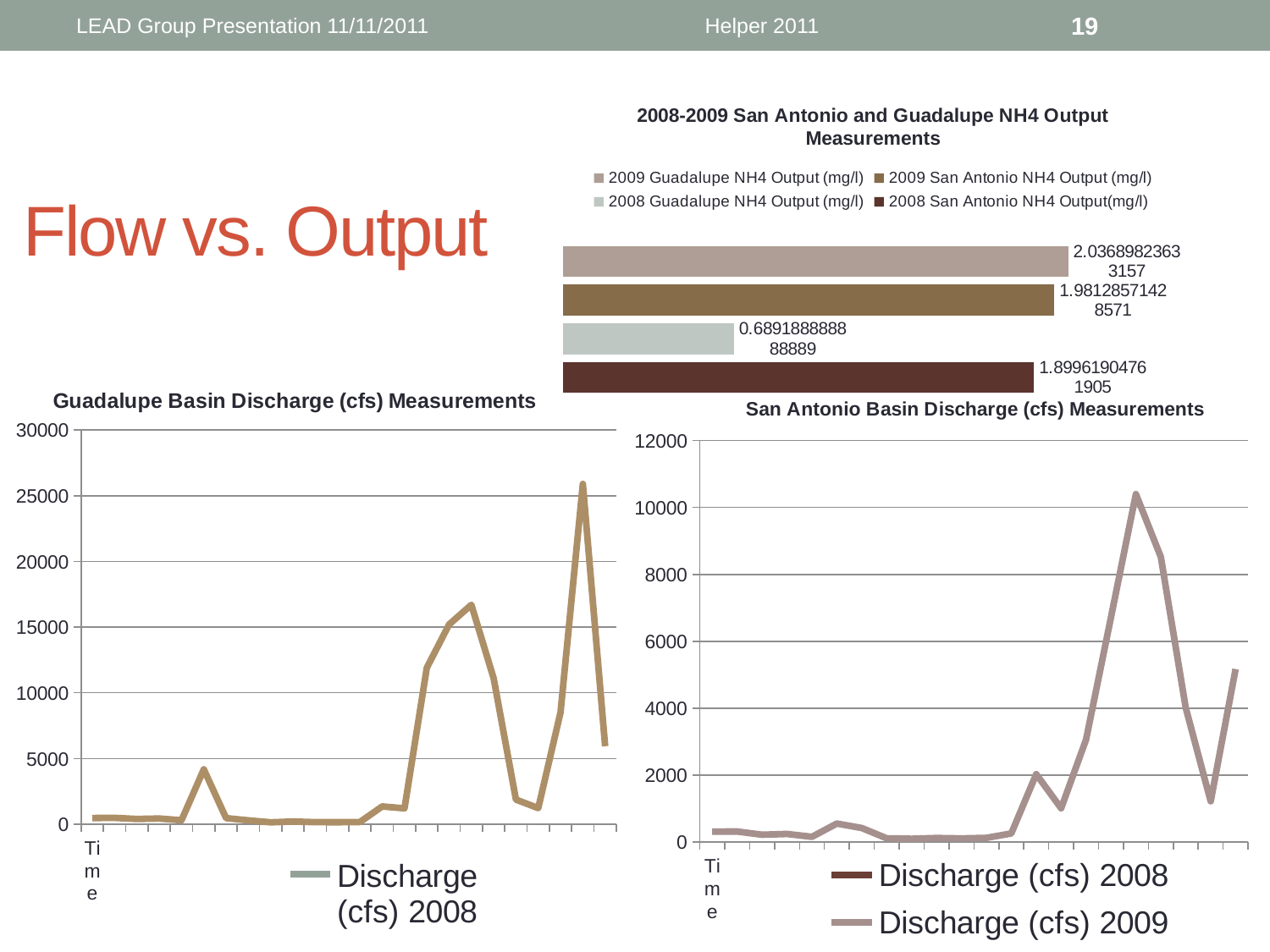
In the NH4 Output Measurements bar chart, what is the value for 2008 San Antonio NH4 Output (mg/l)? 1.89961904761905 In the NH4 Output Measurements bar chart, which is larger: 2009 San Antonio NH4 Output or 2008 San Antonio NH4 Output? 2009 San Antonio NH4 Output What kind of chart is the 'Guadalupe Basin Discharge (cfs) Measurements' chart? line chart In the 'San Antonio Basin Discharge (cfs) Measurements' chart, is the highest peak of the Discharge (cfs) 2009 line greater or less than 10000? greater How many series does the legend of the 'San Antonio Basin Discharge (cfs) Measurements' chart list? 2 In the 'Guadalupe Basin Discharge (cfs) Measurements' chart, is the highest peak of the line greater or less than 25000? greater How many series does the legend of the NH4 Output Measurements bar chart list? 4 In the NH4 Output Measurements bar chart, which series has the highest value? 2009 Guadalupe NH4 Output (mg/l) In the NH4 Output Measurements bar chart, what is the value for 2008 Guadalupe NH4 Output (mg/l)? 0.689188888888889 What kind of chart is the '2008-2009 San Antonio and Guadalupe NH4 Output Measurements' chart? bar chart In the NH4 Output Measurements bar chart, what is the value for 2009 Guadalupe NH4 Output (mg/l)? 2.03689823633157 In the NH4 Output Measurements bar chart, which series has the lowest value? 2008 Guadalupe NH4 Output (mg/l)